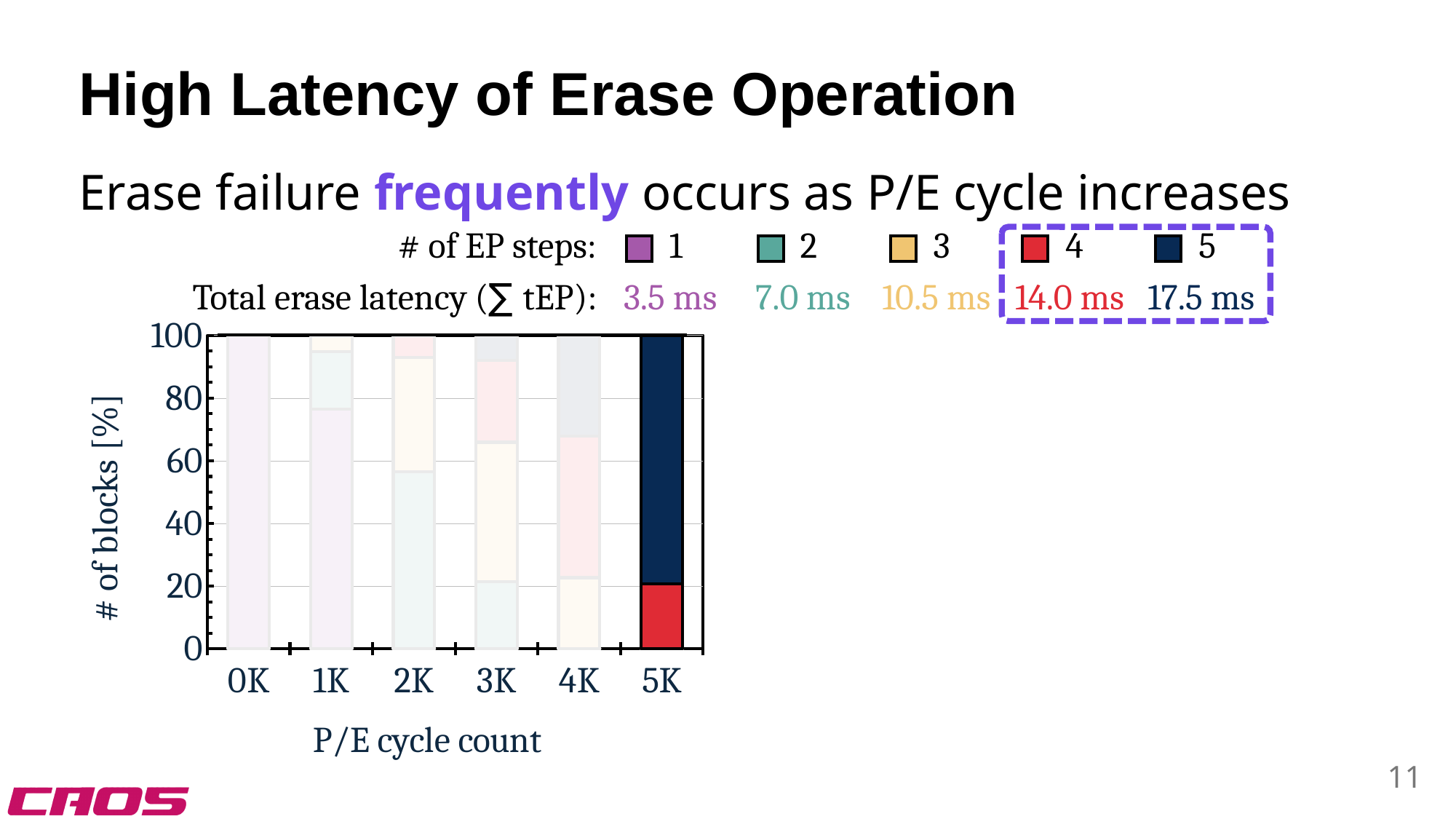
At a P/E cycle count of 5K, which is larger: the share of blocks needing 4 EP steps or the share needing 5 EP steps? 5 EP steps What kind of chart is shown on the slide? stacked bar chart Which P/E cycle count has the largest share of blocks needing 5 EP steps? 5K How many series (numbers of EP steps) does the legend list? 5 How many P/E cycle count categories are shown on the x axis? 6 Is the share of blocks needing 4 EP steps at 5K P/E cycles greater or less than 40%? less Is the share of blocks needing 5 EP steps at 5K P/E cycles greater or less than 60%? greater What is the label of the x axis? P/E cycle count Which P/E cycle count has the largest share of blocks needing only 1 EP step? 0K As the P/E cycle count increases from 0K to 5K, does the share of blocks needing only 1 EP step rise or fall? fall According to the legend, what is the total erase latency for 5 EP steps? 17.5 ms What is the total height of the stacked bar at 5K P/E cycles, in percent? 100